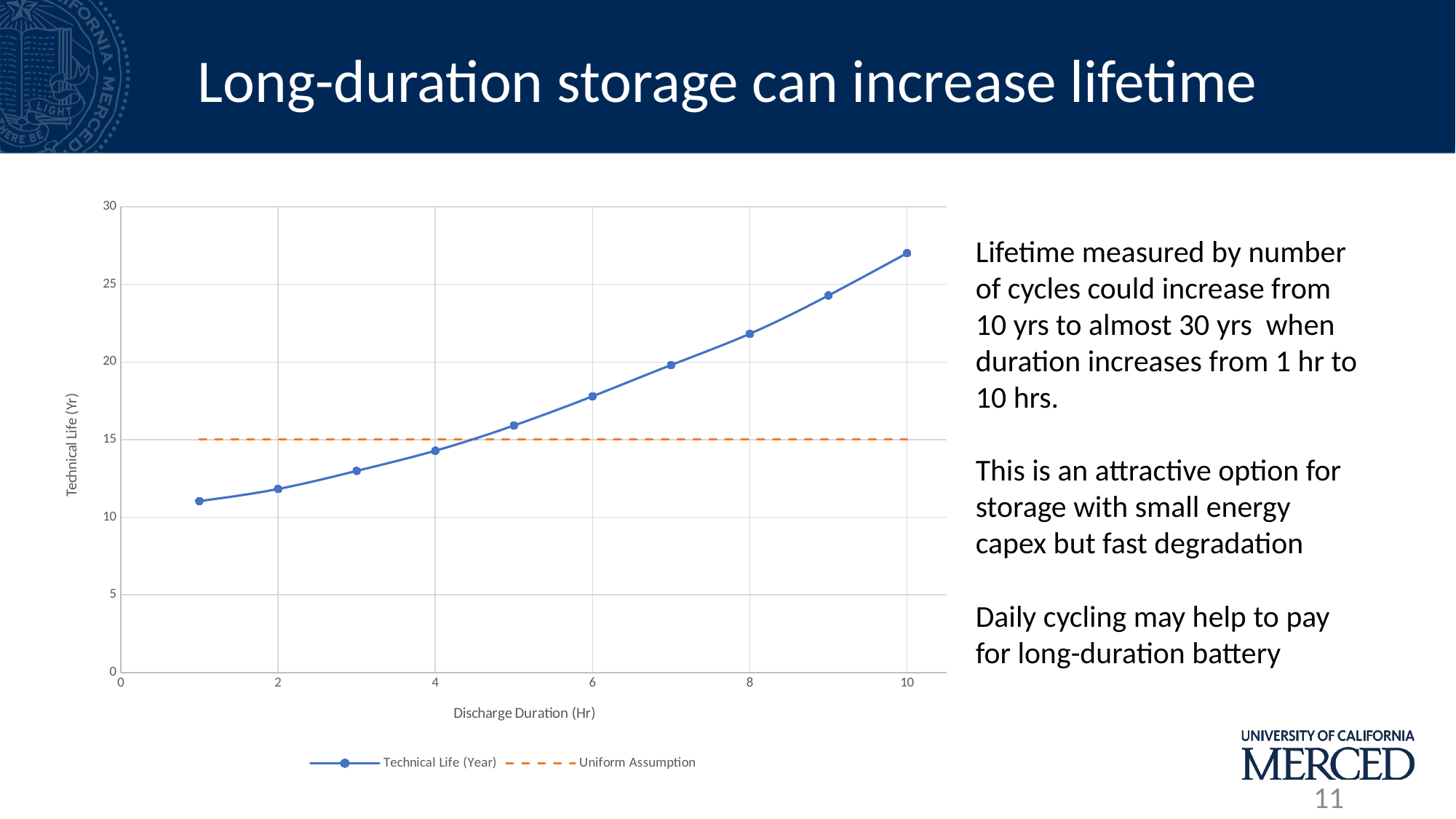
How many series does the chart legend list? 2 What value does the Uniform Assumption line sit at? 15 What kind of chart is shown on the slide? Line chart Is the Technical Life (Year) value at a Discharge Duration of 1 hour greater or less than 15? less At which Discharge Duration is Technical Life (Year) lowest? 1 Which is larger: Technical Life (Year) at 7 hours or at 3 hours of Discharge Duration? 7 hours At which Discharge Duration is Technical Life (Year) highest? 10 How many data points are plotted on the Technical Life (Year) line? 10 Is the Technical Life (Year) value at a Discharge Duration of 10 hours greater or less than 25? greater Does Technical Life (Year) rise or fall as Discharge Duration increases? Rises Is the Technical Life (Year) value at a Discharge Duration of 8 hours greater or less than 20? greater What is the title of the x axis? Discharge Duration (Hr)